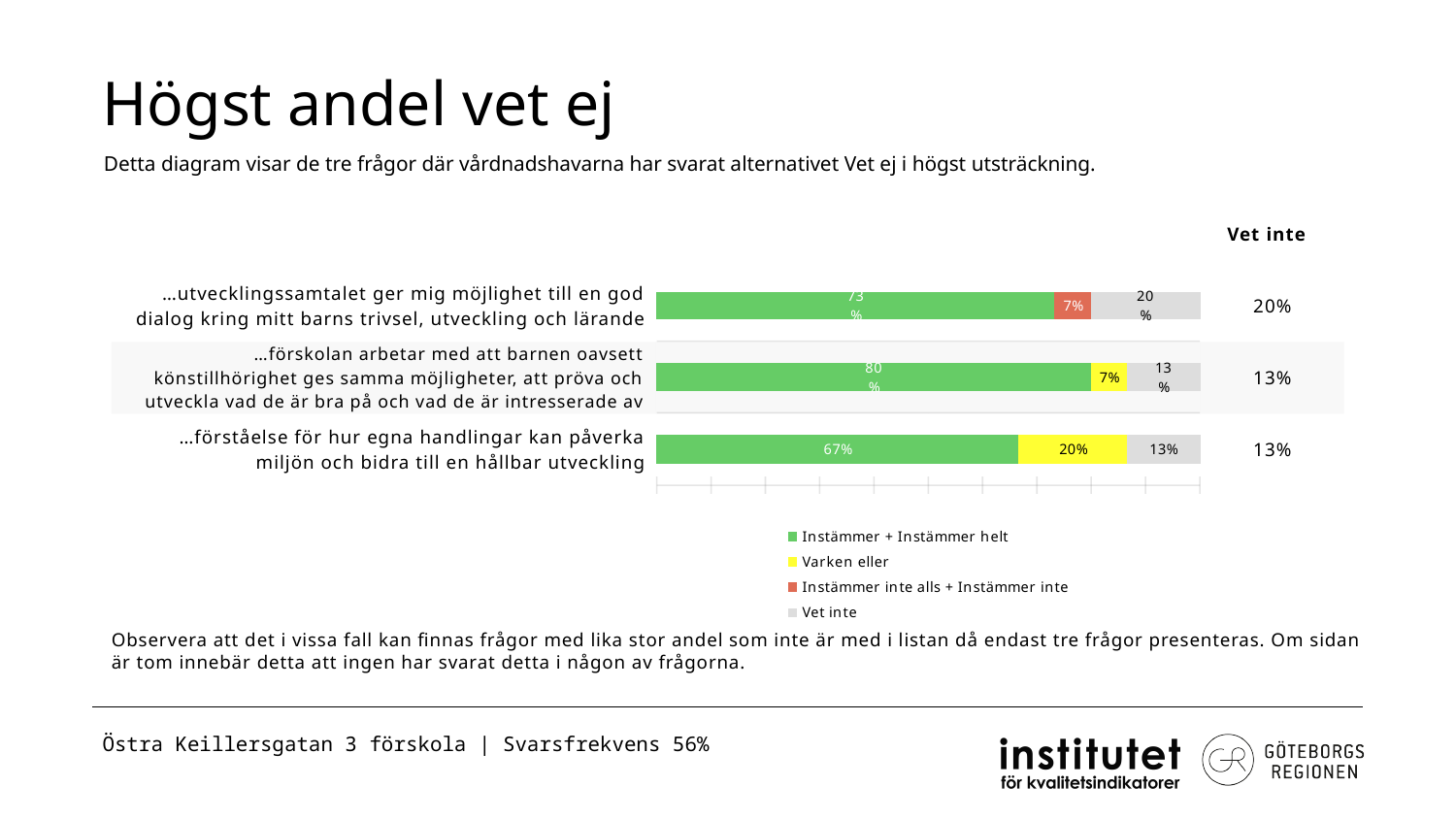
What is the 'Varken eller' value for '…förståelse för hur egna handlingar kan påverka miljön och bidra till en hållbar utveckling'? 20% What kind of chart is shown on the slide? stacked bar chart What is the 'Vet inte' value for '…utvecklingssamtalet ger mig möjlighet till en god dialog kring mitt barns trivsel, utveckling och lärande'? 20% What is the 'Instämmer inte alls + Instämmer inte' value for '…utvecklingssamtalet ger mig möjlighet till en god dialog…'? 7% Which is larger: the 'Vet inte' share for '…utvecklingssamtalet ger mig möjlighet…' or for '…förståelse för hur egna handlingar…'? …utvecklingssamtalet ger mig möjlighet till en god dialog kring mitt barns trivsel, utveckling och lärande How many categories (questions) are plotted in the chart? 3 What is the 'Instämmer + Instämmer helt' value for '…förskolan arbetar med att barnen oavsett könstillhörighet ges samma möjligheter…'? 80% Which category has the highest 'Instämmer + Instämmer helt' share? …förskolan arbetar med att barnen oavsett könstillhörighet ges samma möjligheter, att pröva och utveckla vad de är bra på och vad de är intresserade av Which legend entry is shown in yellow? Varken eller Which category has the lowest 'Instämmer + Instämmer helt' share? …förståelse för hur egna handlingar kan påverka miljön och bidra till en hållbar utveckling What is the difference in 'Instämmer + Instämmer helt' between the '…förskolan arbetar med att barnen oavsett könstillhörighet…' row and the '…förståelse för hur egna handlingar…' row? 13 percentage points How many series does the legend list? 4